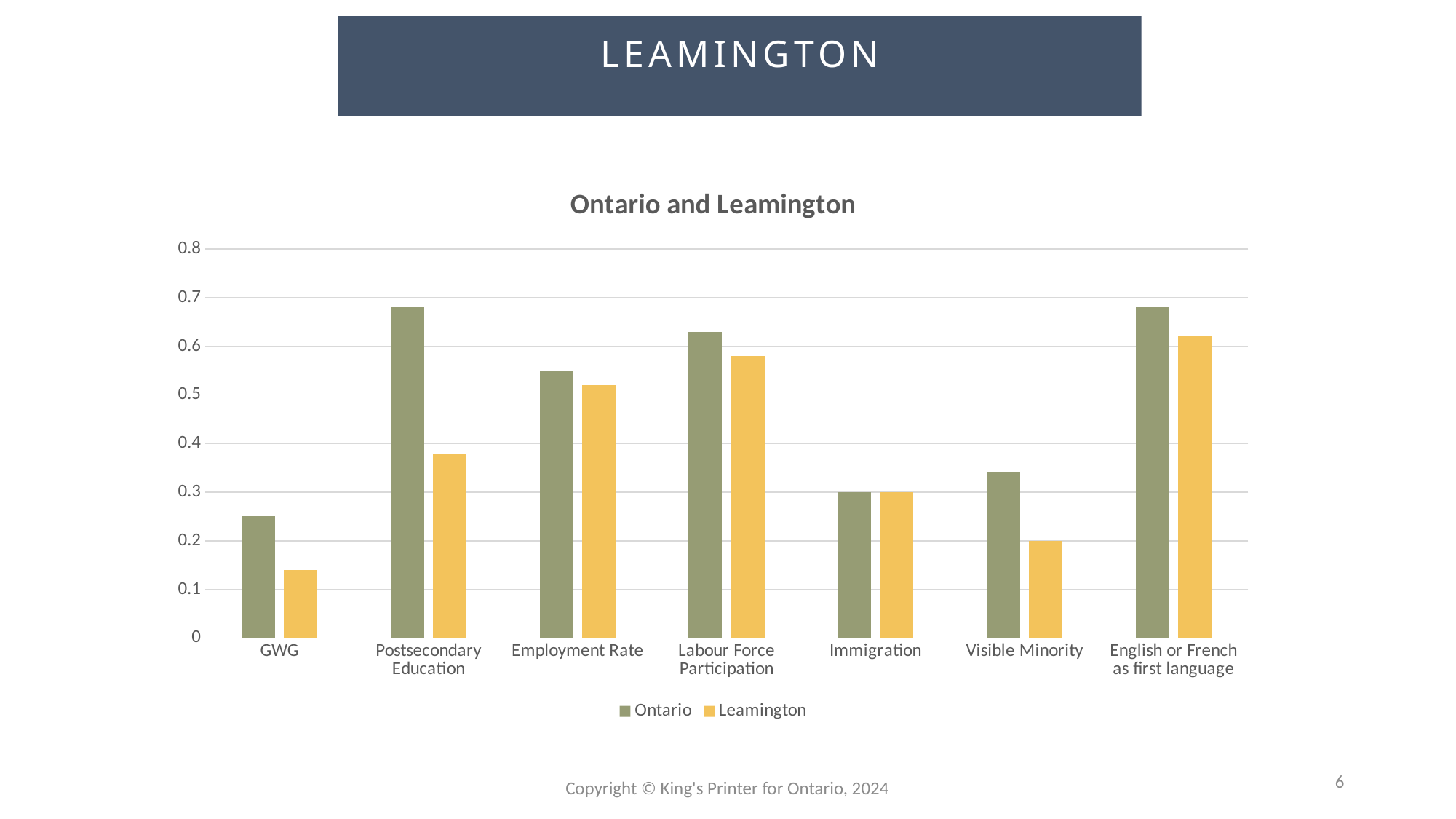
Is the Ontario value for Labour Force Participation greater or less than 0.6? greater For Postsecondary Education, which is larger: the Ontario value or the Leamington value? Ontario Is the Leamington value for GWG greater or less than 0.2? less Which category has the lowest Leamington value? GWG How many categories are shown on the x axis of the chart? 7 Which category has the highest Leamington value? English or French as first language Is the Leamington value for Postsecondary Education greater or less than 0.4? less What is the title of the chart? Ontario and Leamington Which series is shown in yellow in the chart? Leamington What kind of chart is shown on the slide? bar chart How many series does the chart legend list? 2